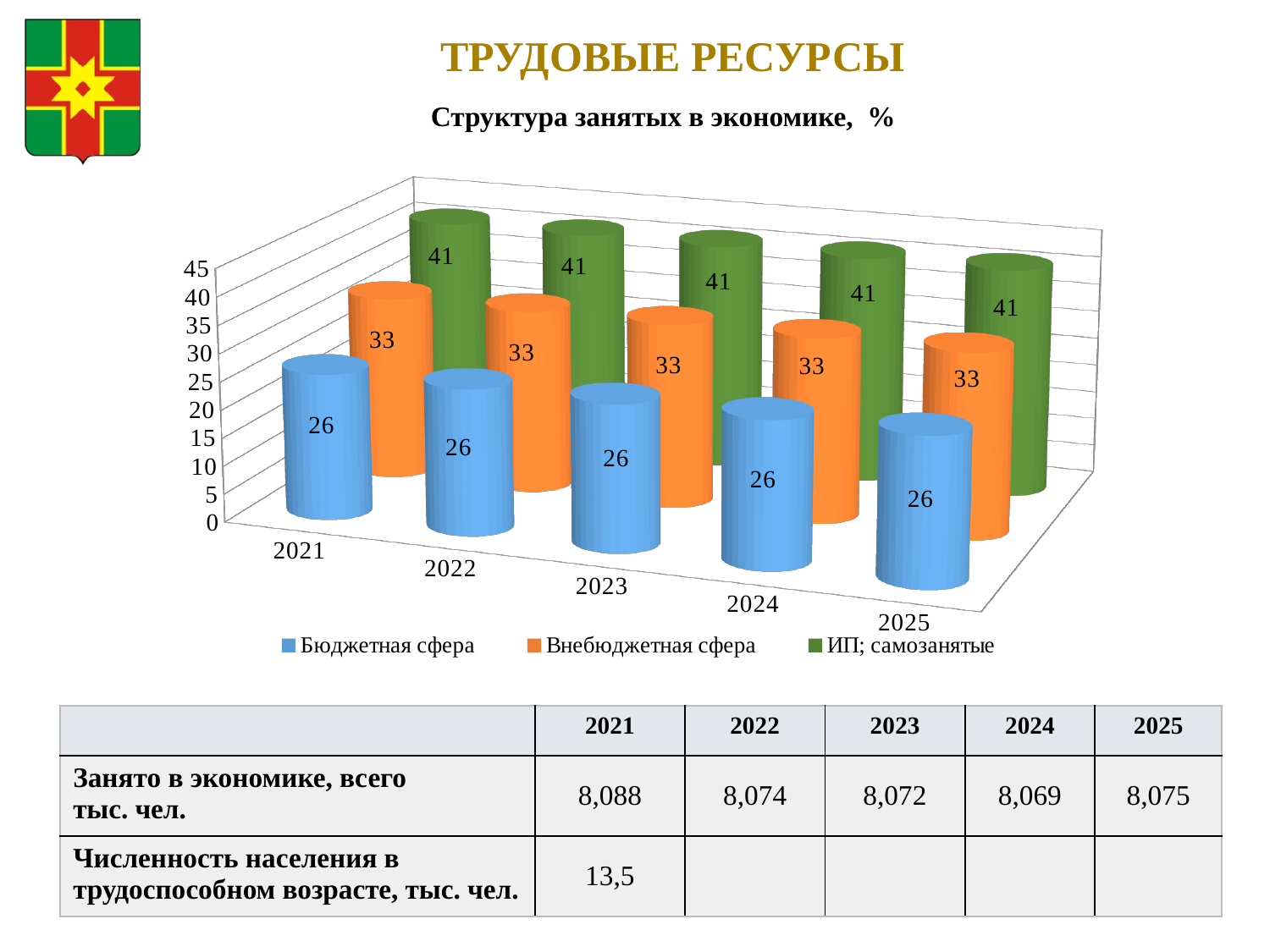
How many series does the chart legend list? 3 Which series has the lowest value in 2022? Бюджетная сфера What is the value for Внебюджетная сфера in 2023? 33 What is the difference between the values for ИП; самозанятые and Бюджетная сфера in 2023? 15 What is the value for ИП; самозанятые in 2025? 41 Which is larger in 2021: Внебюджетная сфера or Бюджетная сфера? Внебюджетная сфера What is the title of the chart? Структура занятых в экономике, % How many years are shown on the x axis of the chart? 5 What is the value for Бюджетная сфера in 2021? 26 What kind of chart is shown on the slide? bar chart Which series has the highest value in 2024? ИП; самозанятые Does the value for Внебюджетная сфера rise, fall or stay the same from 2021 to 2025? stays the same